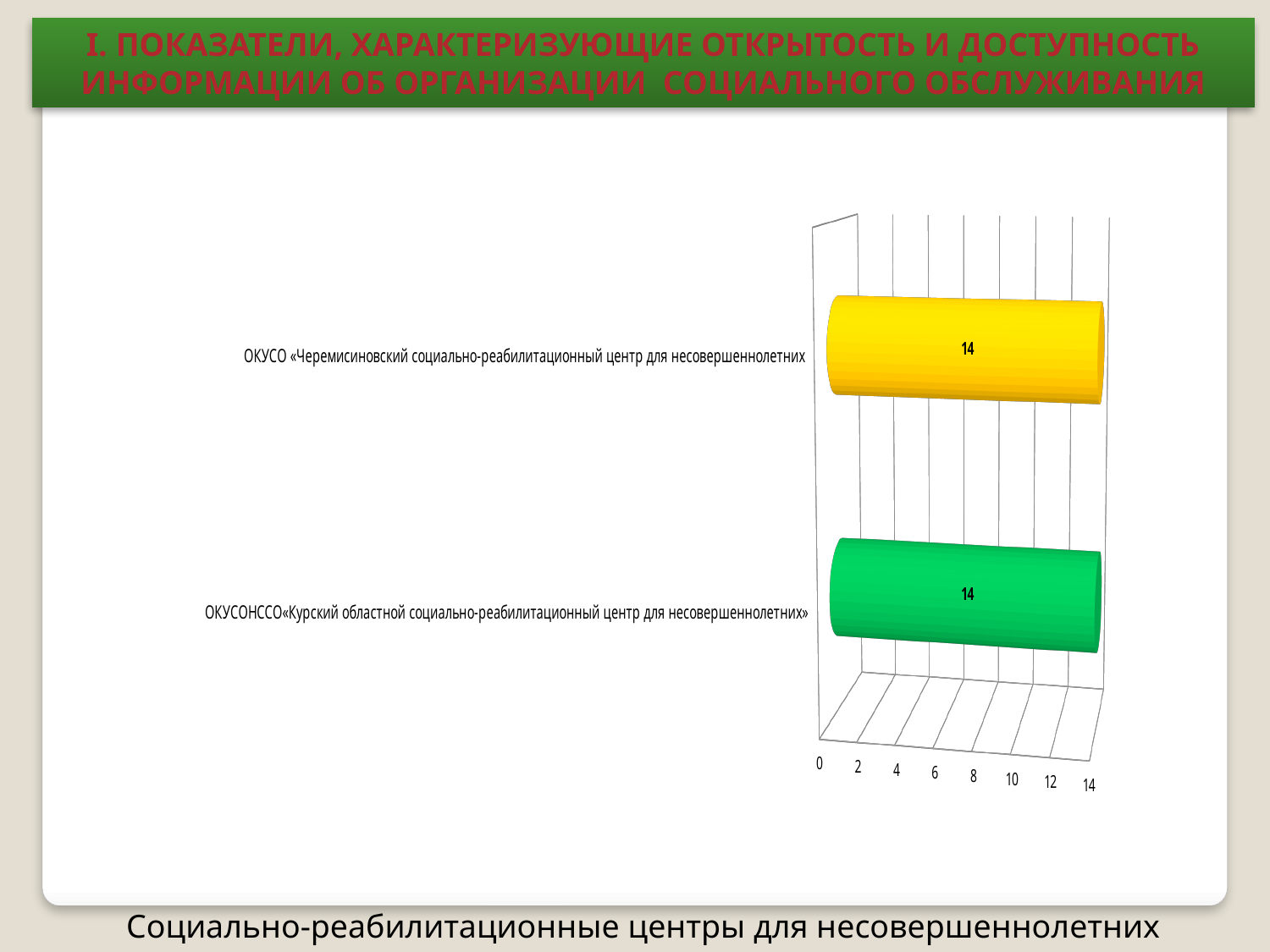
What kind of chart is shown on the slide? Bar chart Is the value for the Черемисиновский centre greater or less than 10? greater Which has the larger value, the Черемисиновский centre or the Курский областной centre? They are equal (both 14) What is the value for ОКУСО «Черемисиновский социально-реабилитационный центр для несовершеннолетних»? 14 What is the value for ОКУСОНССО «Курский областной социально-реабилитационный центр для несовершеннолетних»? 14 What is the highest value shown on the horizontal axis? 14 What colour is the bar for the Курский областной centre? Green How many categories are plotted on the chart? 2 Is the value for the Курский областной centre greater or less than 8? greater What is the difference between the values for the Черемисиновский centre and the Курский областной centre? 0